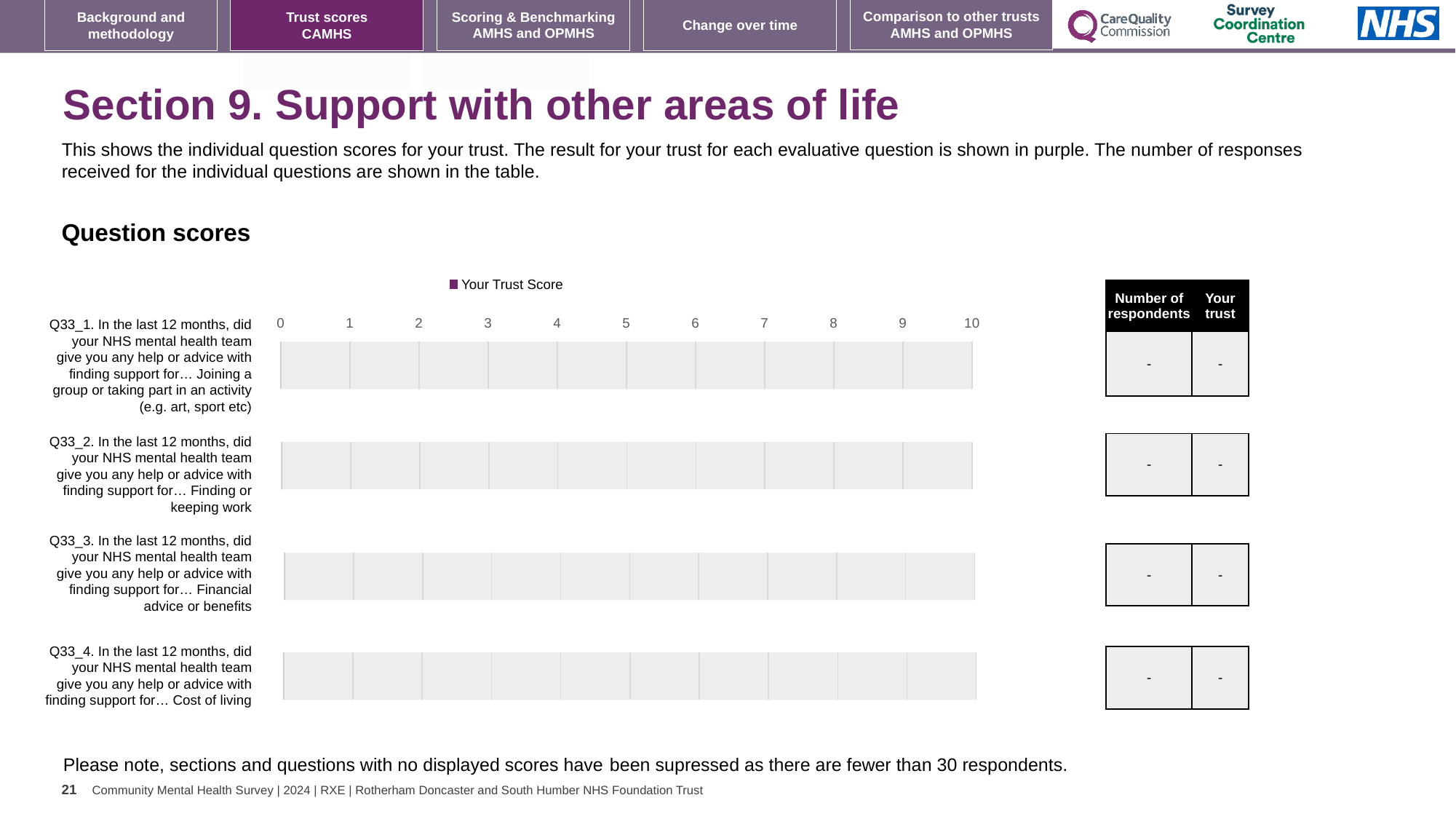
How many questions (categories) are listed on the chart? 4 What is the name of the series shown in the chart legend? Your Trust Score What is shown in the "Number of respondents" column of the table for Q33_4? - What kind of chart is shown under "Question scores"? bar chart What is shown in the "Your trust" column of the table for Q33_1? - What is shown in the "Your trust" column of the table for Q33_3? - What is the highest value shown on the chart's horizontal axis? 10 How many series does the chart legend list? 1